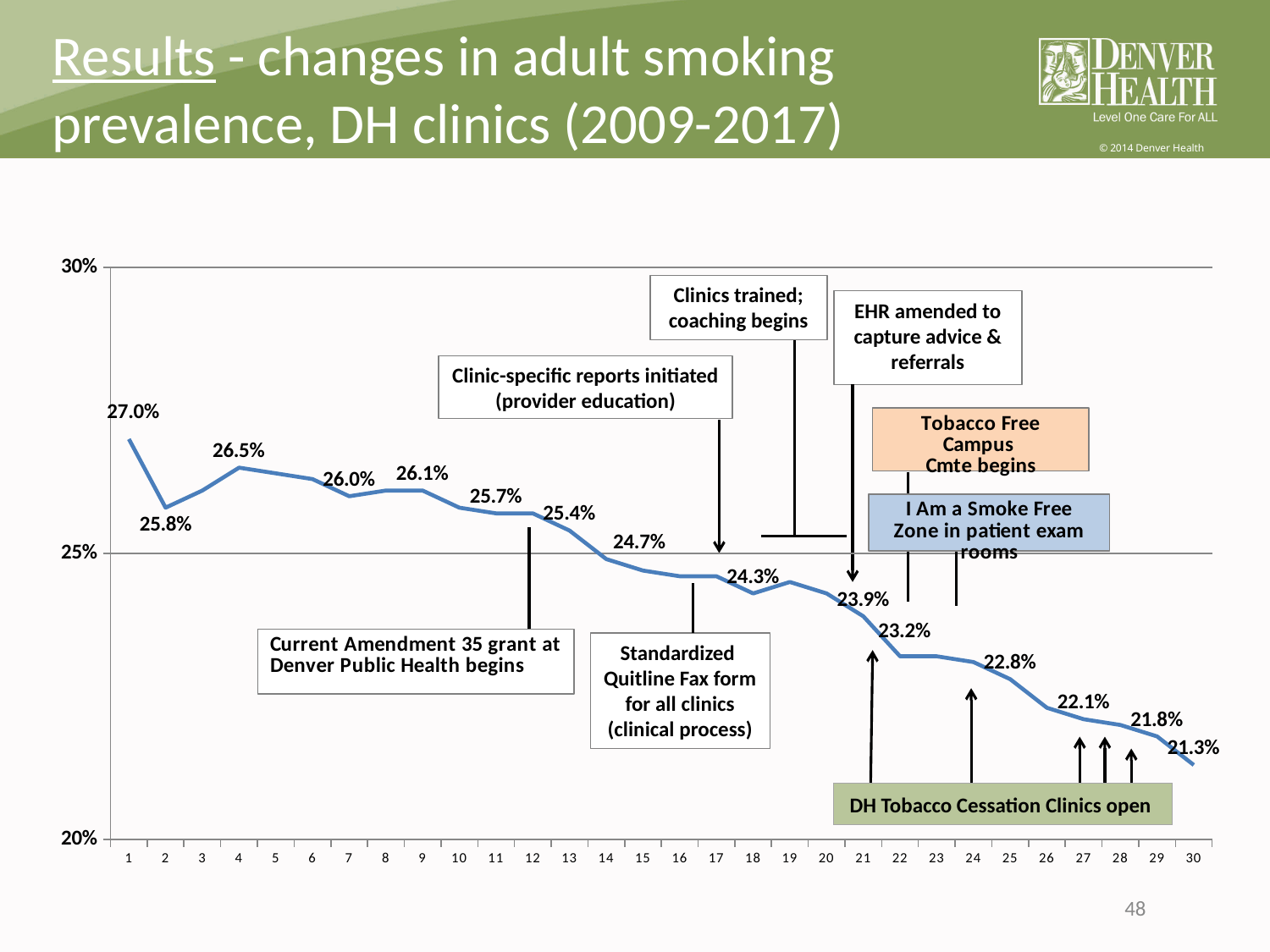
What is the value labeled at point 2, the first dip in the line? 25.8% Is the value at point 30 greater or less than 25%? less Overall, do the values rise or fall from left to right along the x axis? fall What is the highest value labeled on the chart? 27.0% What type of chart is shown on the slide? line chart What is the lowest value labeled on the chart? 21.3% What is the value of the last data point (point 30) on the line? 21.3% What is the difference between the first labeled value (27.0%) and the last labeled value (21.3%)? 5.7% What is the value of the first data point (point 1) on the line? 27.0% How many points are plotted along the x axis? 30 What is the value labeled at point 4, the peak after the first dip? 26.5% Which is larger, the value at point 1 or the value at point 30? point 1